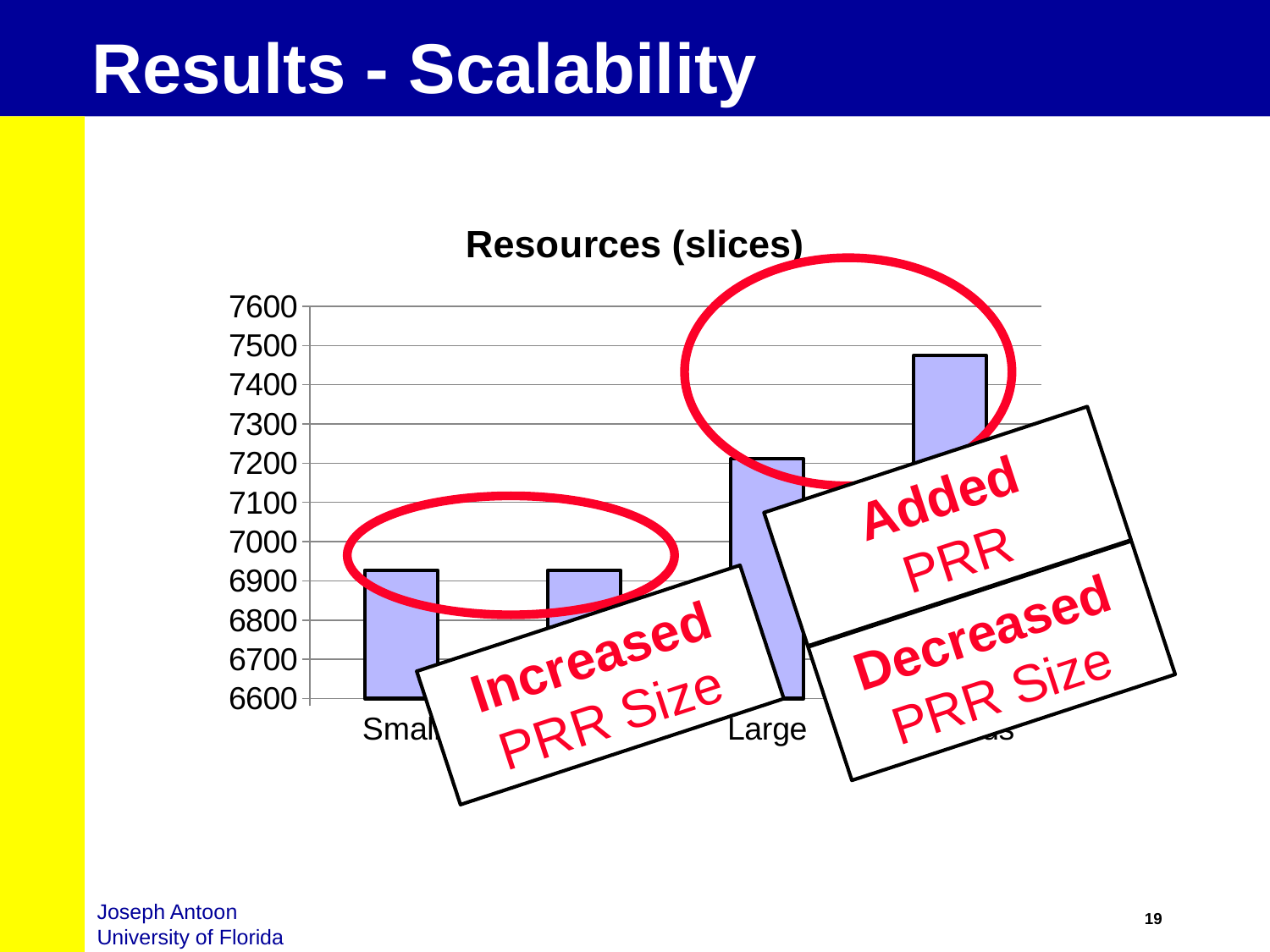
What is the lowest value shown on the vertical axis? 6600 Is the value for Large greater or less than 7300? less What is the title of the chart? Resources (slices) Is the value for Small greater or less than 6800? greater How many bars are plotted in the chart? 4 Is the value for Large greater or less than 7000? greater Which has the larger value, Small or Large? Large Do the bar values generally rise or fall from left to right along the x axis? rise What kind of chart is shown on the slide? bar chart